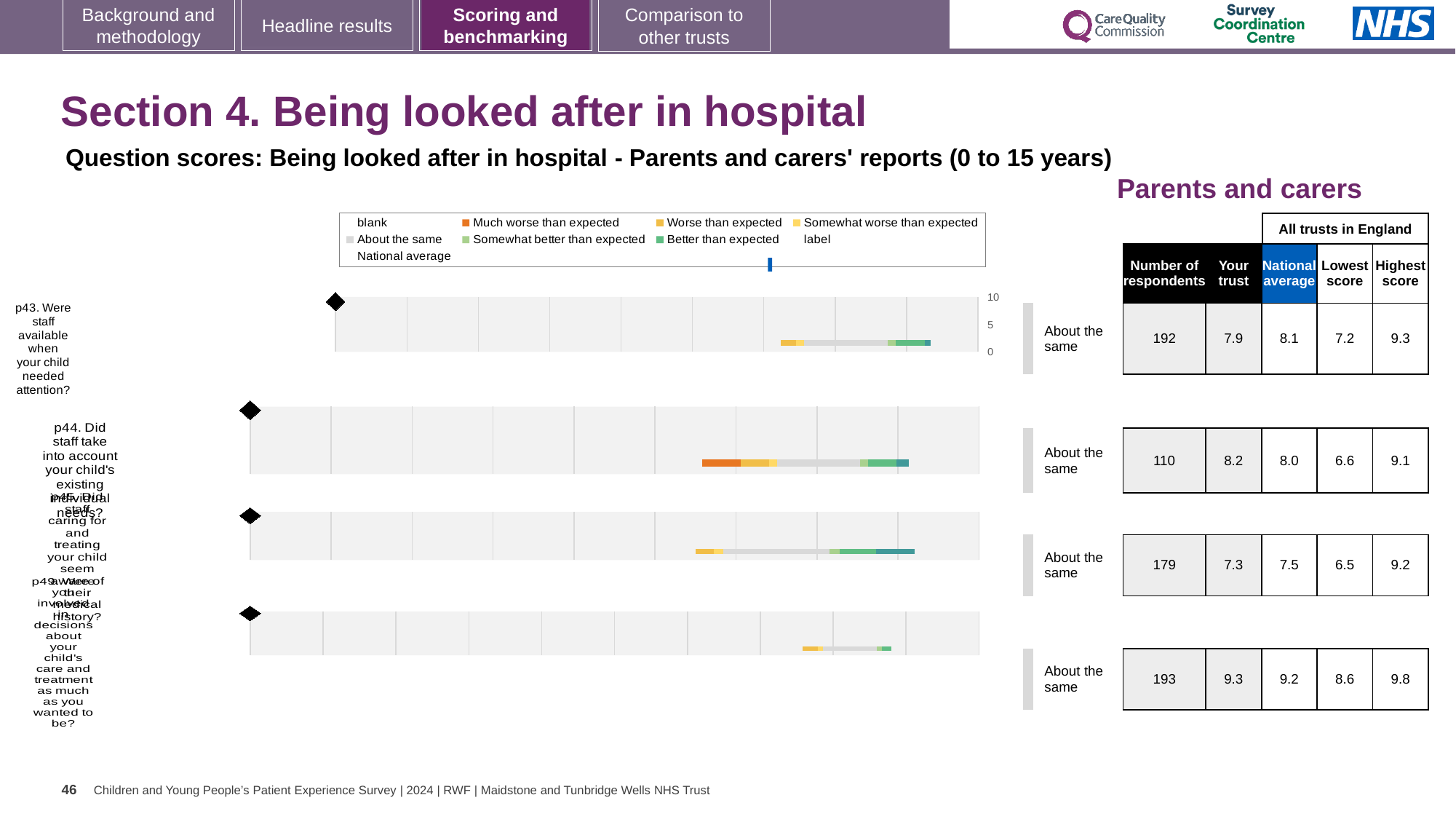
What kind of chart is used to show the question scores on this slide? bar chart For p44, which is larger: the 'Your trust' score or the national average? Your trust (8.2) For p43 (Were staff available when your child needed attention?), what is the national average score? 8.1 Which question row has the lowest 'Your trust' score? The third row, 7.3 For p43, what is the difference between the highest score and the lowest score across all trusts in England? 2.1 How many respondents are listed for p44 (Did staff take into account your child's existing individual needs?)? 110 What is the subtitle describing the question scores shown on the slide? Question scores: Being looked after in hospital - Parents and carers' reports (0 to 15 years) How many question rows (charts) are shown on the slide? 4 What benchmark category is shown for p43 (Were staff available when your child needed attention?)? About the same Which question row has the highest 'Your trust' score? The fourth (bottom) row, 9.3 For p43 (Were staff available when your child needed attention?), what is the 'Your trust' score? 7.9 What is the highest score across all trusts in England for the fourth (bottom) question row? 9.8